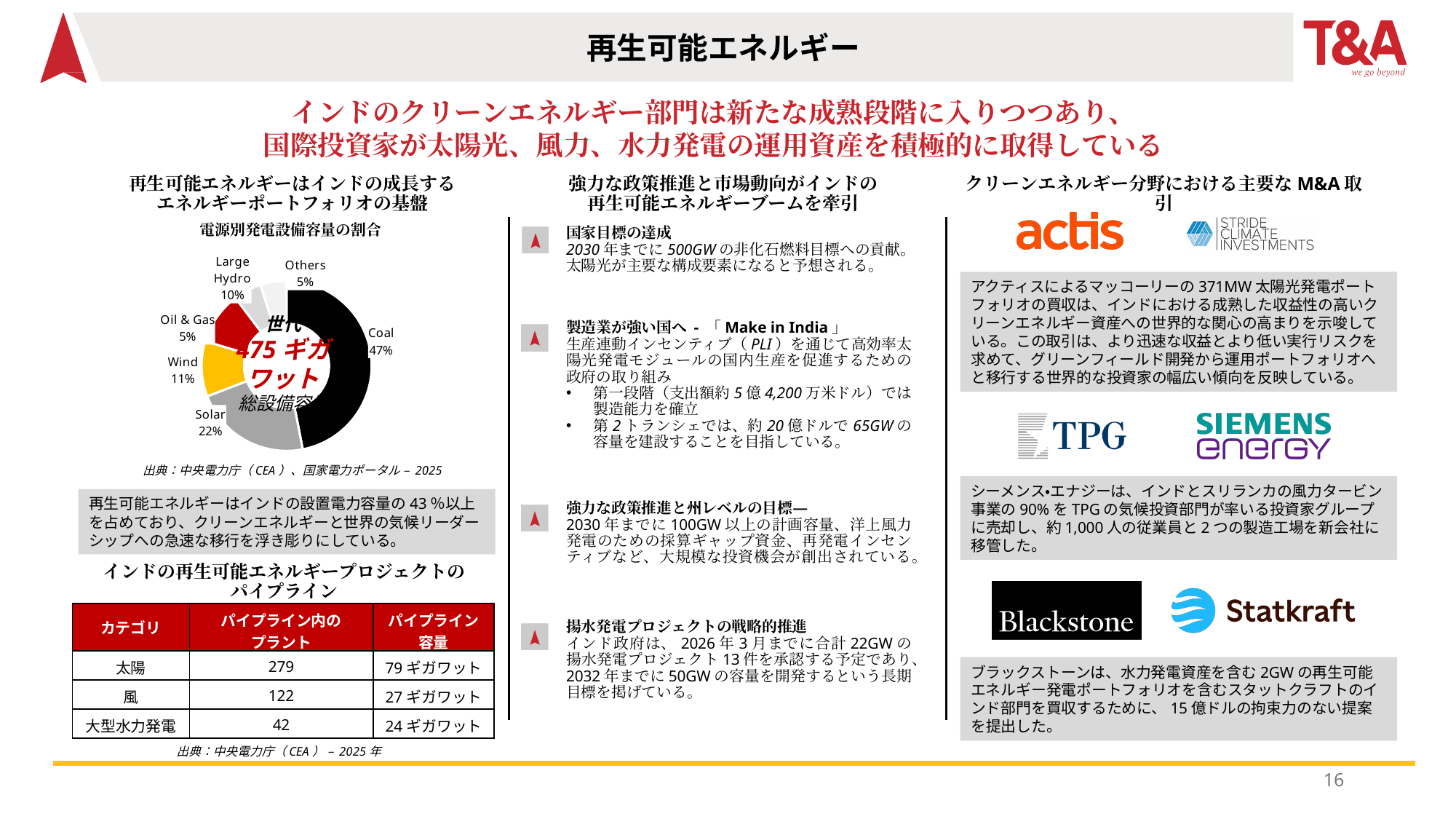
What kind of chart is 電源別発電設備容量の割合? Donut (pie) chart What is the share of Solar in the donut chart? 22% Which category has the largest share in the donut chart? Coal What is the title of the donut chart on the slide? 電源別発電設備容量の割合 What is the difference in percentage points between Coal and Solar in the donut chart? 25 percentage points What is the share of Oil & Gas in the donut chart? 5% What is the share of Wind in the donut chart? 11% What is the combined share of Solar and Wind in the donut chart? 33% What is the share of Coal in the donut chart 電源別発電設備容量の割合? 47% Which has a larger share in the donut chart, Wind or Large Hydro? Wind What is the share of Large Hydro in the donut chart? 10% How many categories are shown in the donut chart? 6